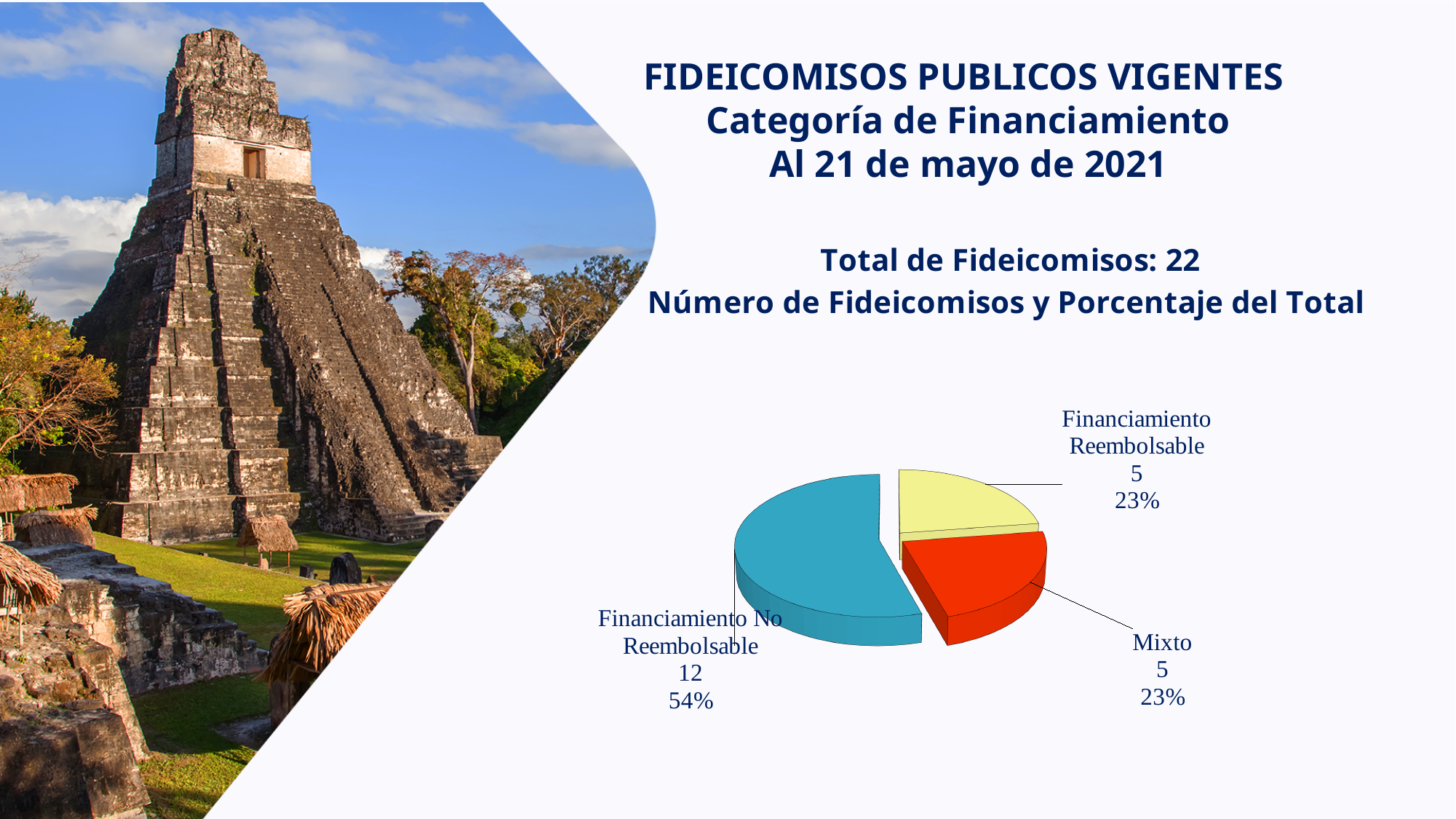
What kind of chart is shown on the slide? Pie chart How many fideicomisos are in the Financiamiento No Reembolsable category? 12 Which category has the largest number of fideicomisos? Financiamiento No Reembolsable How many categories does the pie chart show? 3 What date is given in the chart title? 21 de mayo de 2021 What percentage of the total does Financiamiento Reembolsable represent? 23% What is the difference in the number of fideicomisos between Financiamiento No Reembolsable and Mixto? 7 What colour is the Mixto slice of the pie chart? Red What percentage of the total does Financiamiento No Reembolsable represent? 54% How many fideicomisos are in the Mixto category? 5 What is the total number of fideicomisos stated on the slide? 22 Which is larger: the number of fideicomisos for Financiamiento No Reembolsable or for Financiamiento Reembolsable? Financiamiento No Reembolsable